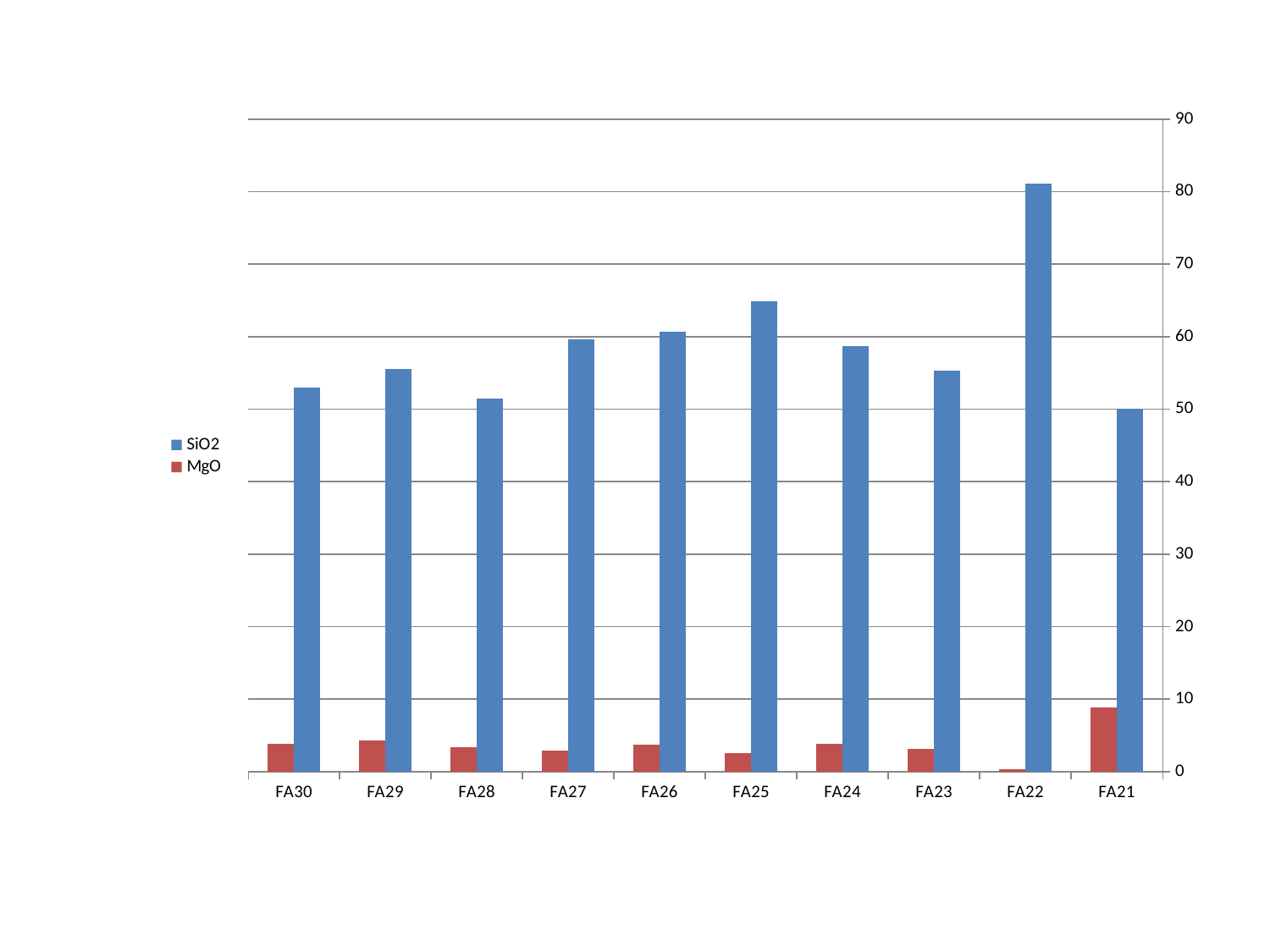
Which is larger, the SiO2 value for FA22 or the SiO2 value for FA25? FA22 How many categories are shown on the x axis? 10 Which category has the highest SiO2 value? FA22 Is the MgO value for FA21 greater or less than 10? less Which series is shown in red? MgO Which is larger, the MgO value for FA21 or the MgO value for FA30? FA21 Which category has the lowest MgO value? FA22 Which category has the highest MgO value? FA21 Is the SiO2 value for FA25 greater or less than 60? greater What kind of chart is shown on the slide? bar chart How many series does the legend list? 2 Is the SiO2 value for FA22 greater or less than 70? greater